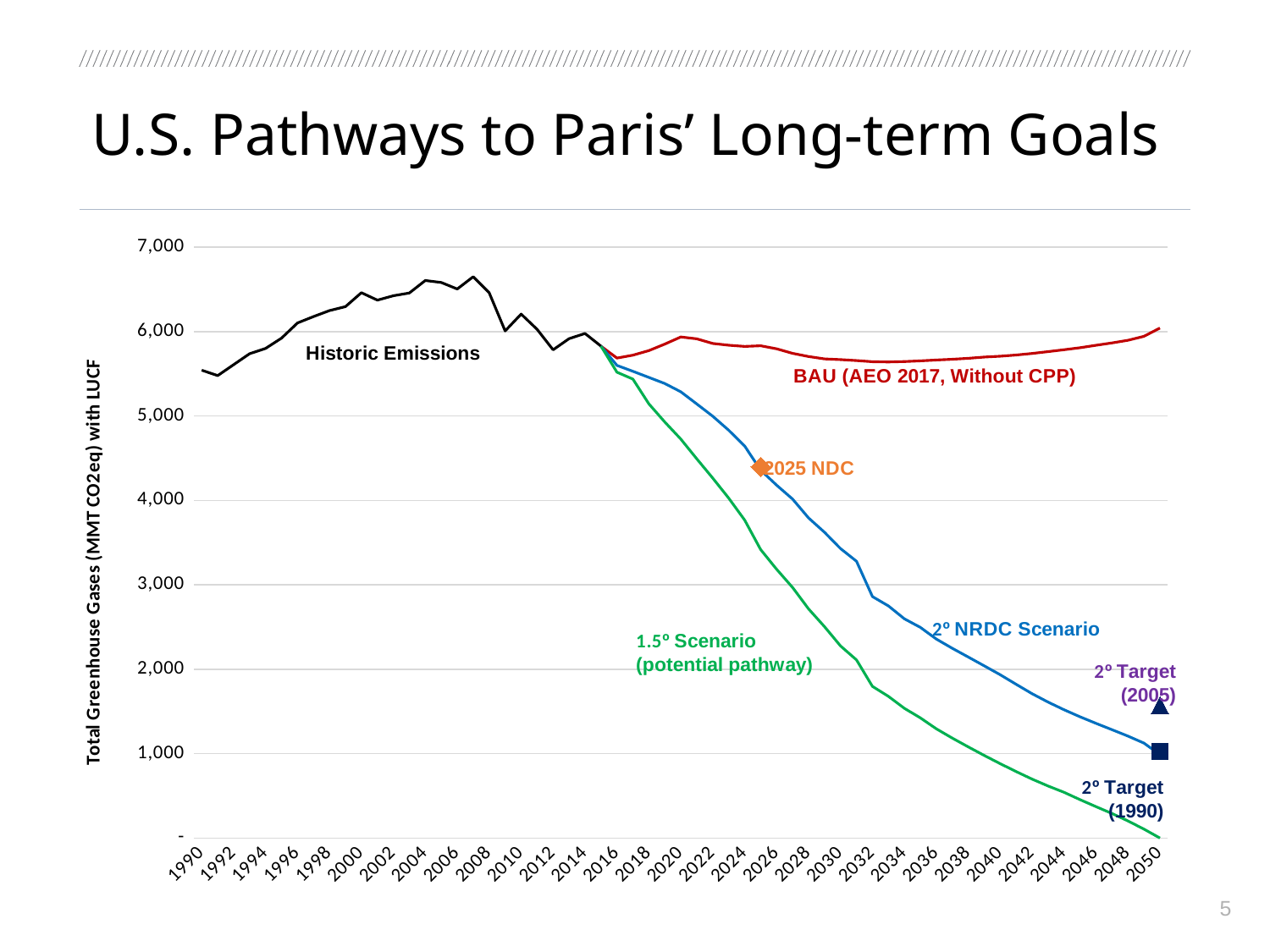
Is the peak of Historic Emissions around 2007 greater or less than 6,000? greater What is the label on the vertical axis of the chart? Total Greenhouse Gases (MMT CO2eq) with LUCF Is the value of the 2º NRDC Scenario in 2030 greater or less than 3,000? greater Is the value of the 1.5º Scenario (potential pathway) in 2050 greater or less than 1,000? less Which marker is higher on the chart: 2º Target (2005) or 2º Target (1990)? 2º Target (2005) What colour is the line for BAU (AEO 2017, Without CPP)? Red Does the 1.5º Scenario (potential pathway) rise or fall from 2016 to 2050? Fall What kind of chart is shown on the slide? Line chart In 2040, which is higher: the 2º NRDC Scenario or the 1.5º Scenario (potential pathway)? 2º NRDC Scenario Which series has the highest value in 2050? BAU (AEO 2017, Without CPP)